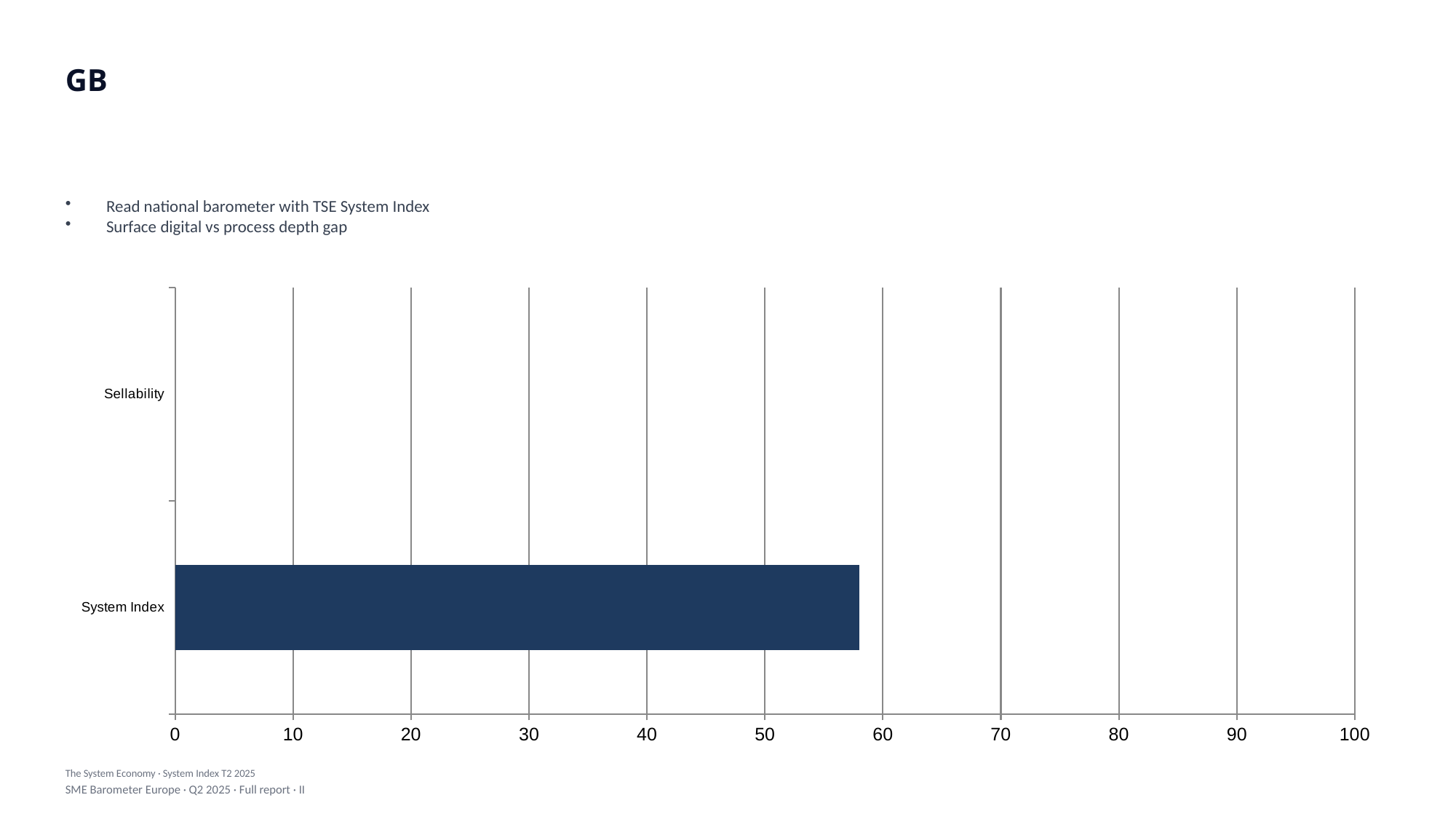
Which category has the highest value in the chart? System Index What is the maximum value shown on the horizontal axis of the chart? 100 How many categories are shown on the vertical axis of the chart? 2 Is the value for System Index greater or less than 50? greater What kind of chart is shown on the slide? bar chart What is the title of the slide containing the chart? GB Is the value for System Index greater or less than 40? greater Which of the two categories, Sellability or System Index, has the larger value? System Index Is the value for System Index greater or less than 60? less